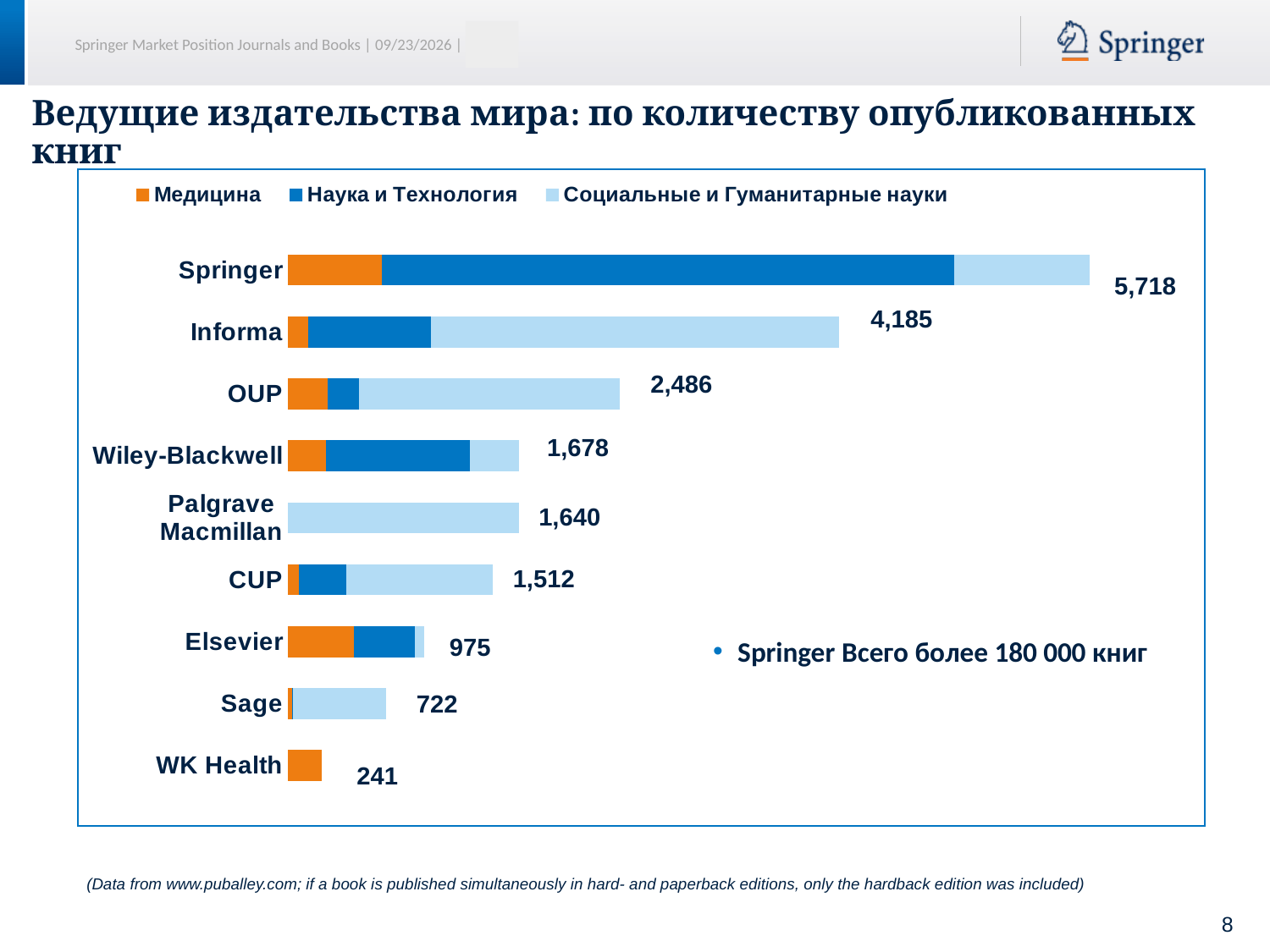
What is the total value shown for Informa? 4,185 How many series does the legend list? 3 What is the total value shown for OUP? 2,486 What is the difference between the totals for Springer and Informa? 1,533 What is the difference between the totals for Elsevier and Sage? 253 Which publisher has the highest total number of published books? Springer Which has a larger total, Wiley-Blackwell or Palgrave Macmillan? Wiley-Blackwell How many publishers are shown in the chart? 9 What is the total value shown for WK Health? 241 Which publisher has the lowest total number of published books? WK Health What kind of chart is shown on the slide? Stacked bar chart What is the total number of published books shown for Springer? 5,718